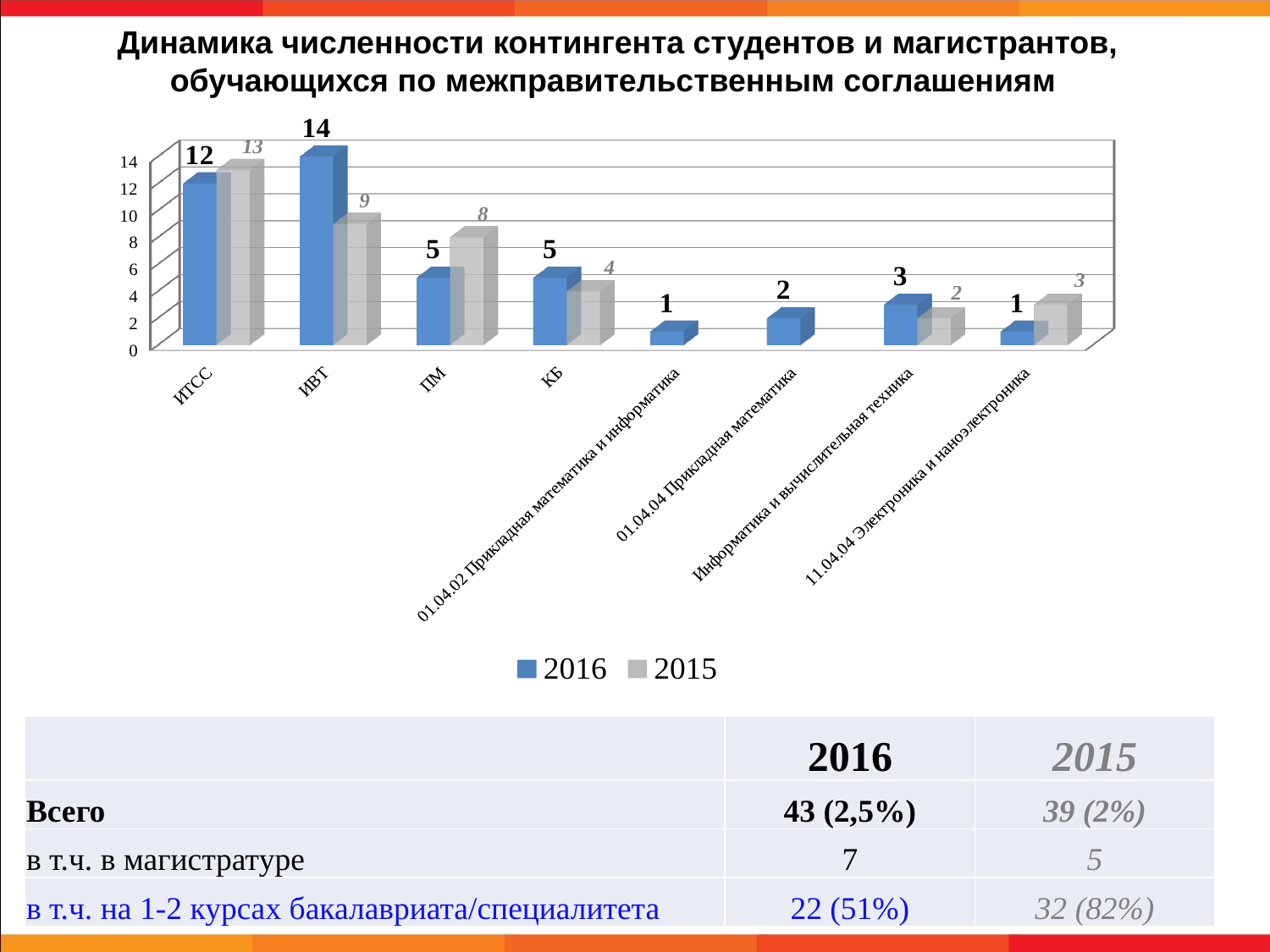
How many categories are shown on the x axis? 8 What is the 2015 value for ИТСС? 13 How many series does the legend list? 2 Which is larger for ПМ: the 2016 value or the 2015 value? 2015 What is the 2016 value for ИВТ? 14 What is the difference between the 2016 and 2015 values for ИВТ? 5 Which colour represents the 2016 series in the chart? Blue What is the 2016 value for Информатика и вычислительная техника? 3 Which category has the lowest 2015 value among those with a 2015 bar? Информатика и вычислительная техника What is the 2015 value for ПМ? 8 What kind of chart is shown on the slide? Bar chart Which category has the highest 2016 value? ИВТ